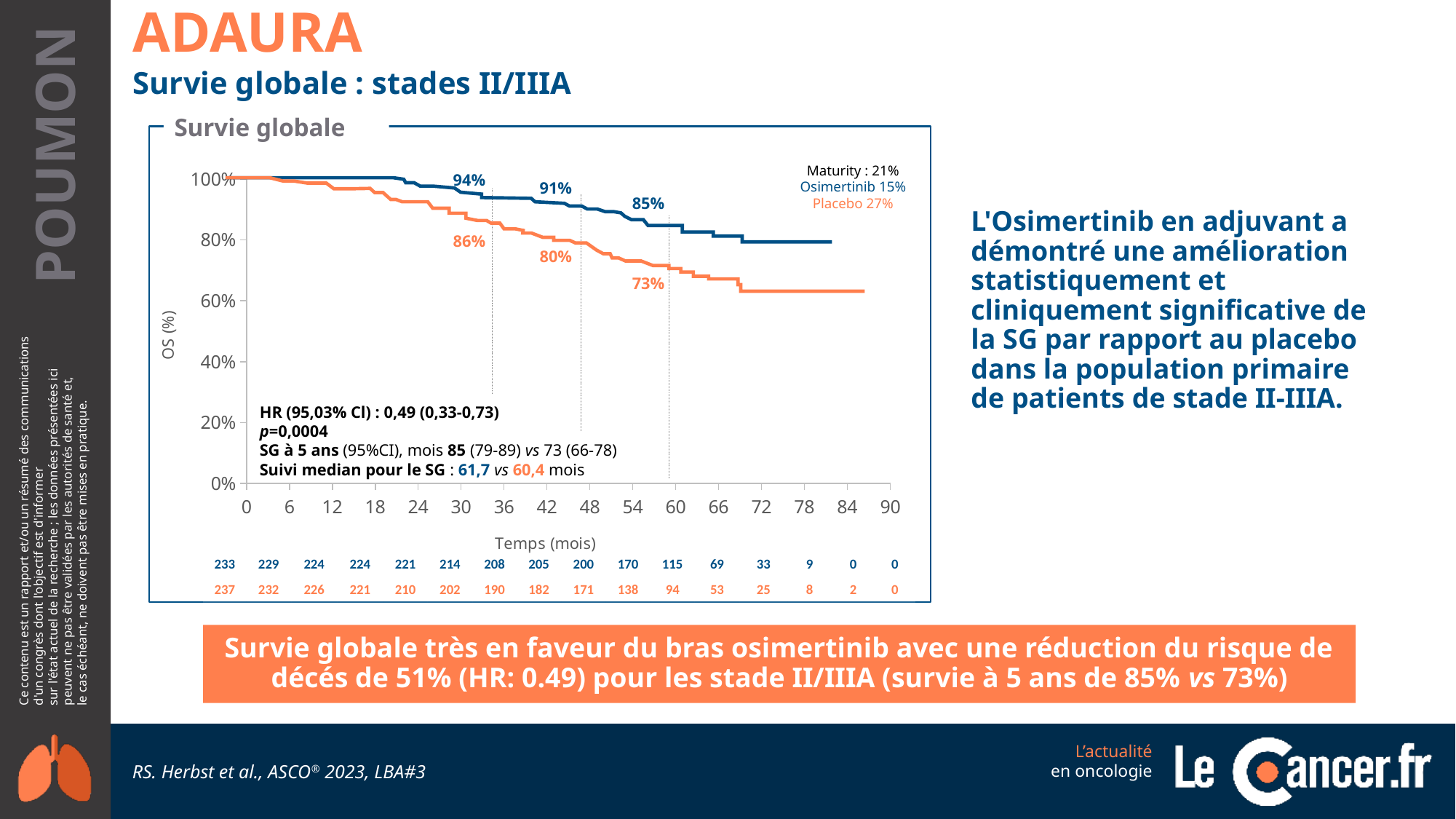
What is the first labelled survival value on the Placebo curve (at about 36 months)? 86% What is the first labelled survival value on the Osimertinib curve (at about 36 months)? 94% How many patients were at risk in the Osimertinib arm at time 0? 233 What is the x-axis label of the chart? Temps (mois) What is the maturity percentage reported for the Placebo arm? 27% What type of chart is shown on the slide? Line chart (Kaplan-Meier survival curve) What is the difference between the 5-year survival values of Osimertinib (85%) and Placebo (73%)? 12% Which curve is higher at 48 months, Osimertinib (91%) or Placebo (80%)? Osimertinib What is the y-axis label of the chart? OS (%) What is the 5-year overall survival value labelled on the Osimertinib curve? 85% Do the survival curves rise or fall as time increases along the x axis? Fall What is the 5-year overall survival value labelled on the Placebo curve? 73%